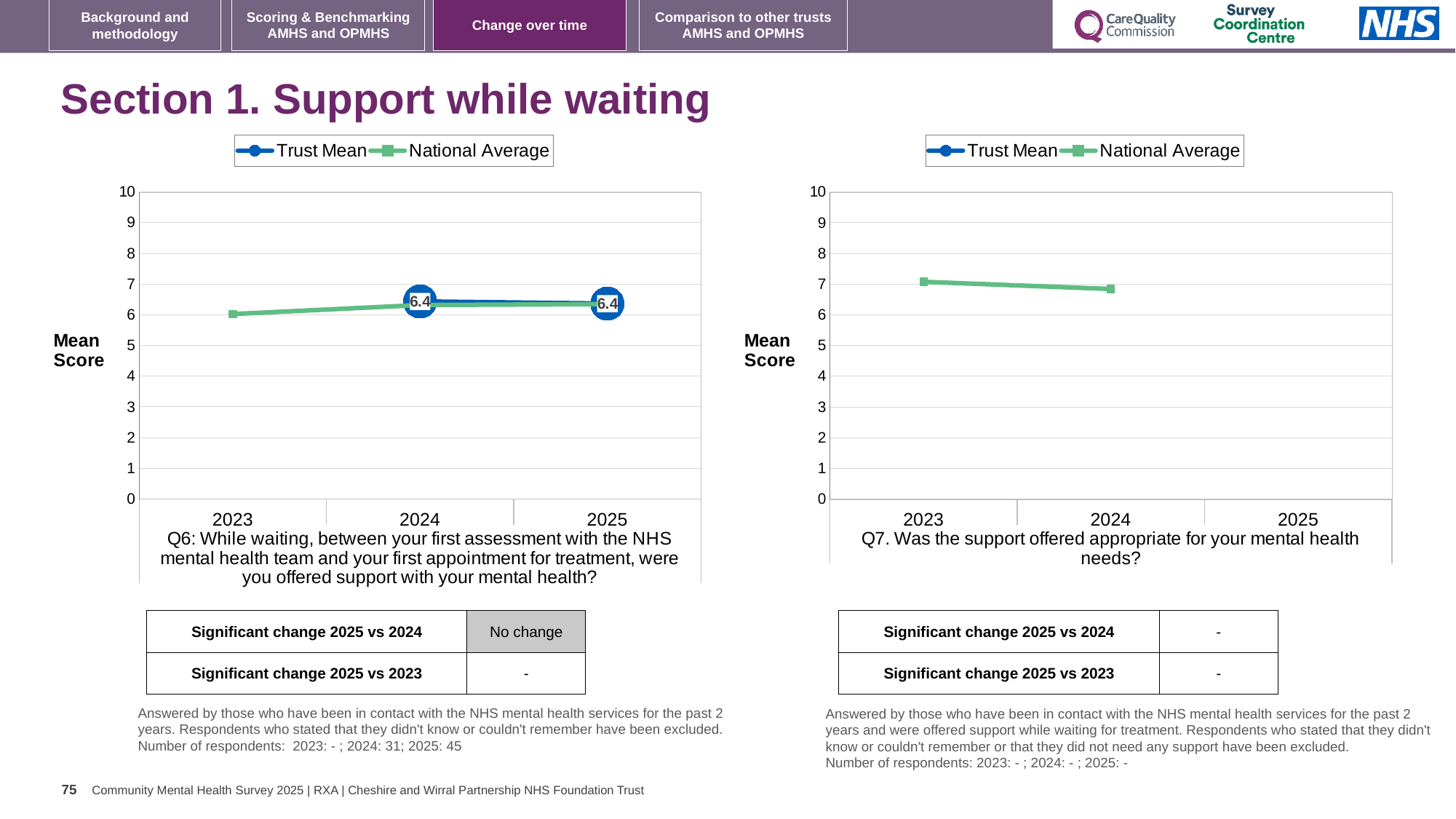
In the Q6 chart on the left, what is the Trust Mean value for 2025? 6.4 In the Q6 chart on the left, what is the Trust Mean value for 2024? 6.4 What is the y-axis label on the Q6 chart on the left? Mean Score In the Q7 chart on the right, does the National Average rise or fall from 2023 to 2024? fall What are the two legend entries in the Q6 chart on the left? Trust Mean and National Average In the Q7 chart on the right, is the National Average value for 2024 greater or less than 8? less How many series does the legend of the Q7 chart on the right list? 2 What kind of chart is the Q6 chart on the left? Line chart In the Q7 chart on the right, is the National Average value for 2023 greater or less than 5? greater In the Q6 chart on the left, what is the difference between the Trust Mean values for 2025 and 2024? 0 In the Q6 chart on the left, is the National Average value for 2023 greater or less than 5? greater How many years are shown on the x axis of the Q6 chart on the left? 3